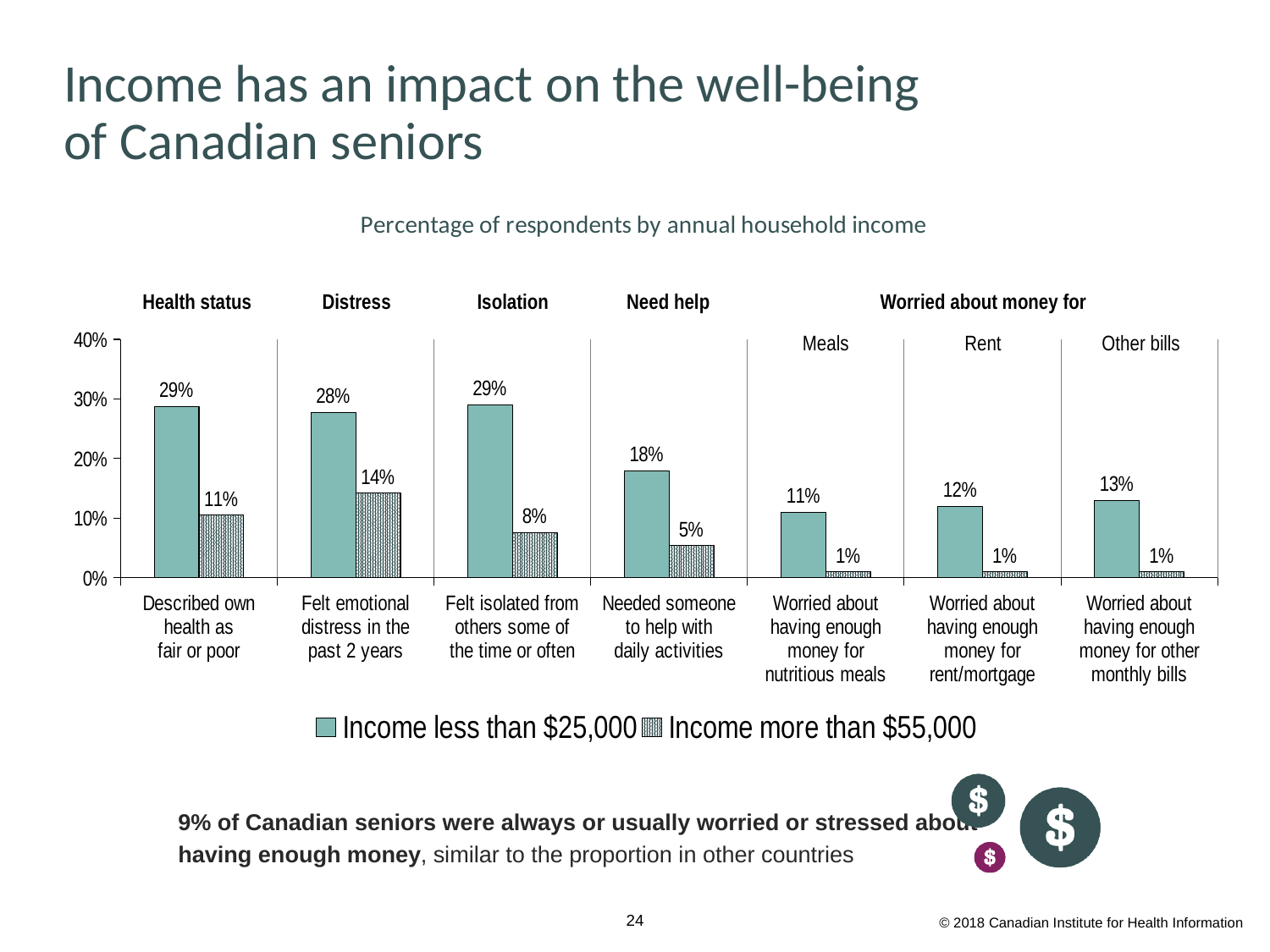
Which category has the lowest value for the Income less than $25,000 series? Worried about having enough money for nutritious meals What is the subtitle printed above the chart? Percentage of respondents by annual household income Which category has the highest value for the Income more than $55,000 series? Felt emotional distress in the past 2 years What percentage of respondents with income more than $55,000 felt emotional distress in the past 2 years? 14% How many series does the legend list? 2 What kind of chart is shown on the slide? Bar chart What is the difference between the two income groups for 'Felt isolated from others some of the time or often'? 21 percentage points For 'Worried about having enough money for other monthly bills', which income group has the larger value? Income less than $25,000 What percentage of respondents with income more than $55,000 were worried about having enough money for rent/mortgage? 1% How many categories are shown on the x axis of the chart? 7 What percentage of respondents with income less than $25,000 described their own health as fair or poor? 29% What is the difference between the two income groups for 'Needed someone to help with daily activities'? 13 percentage points